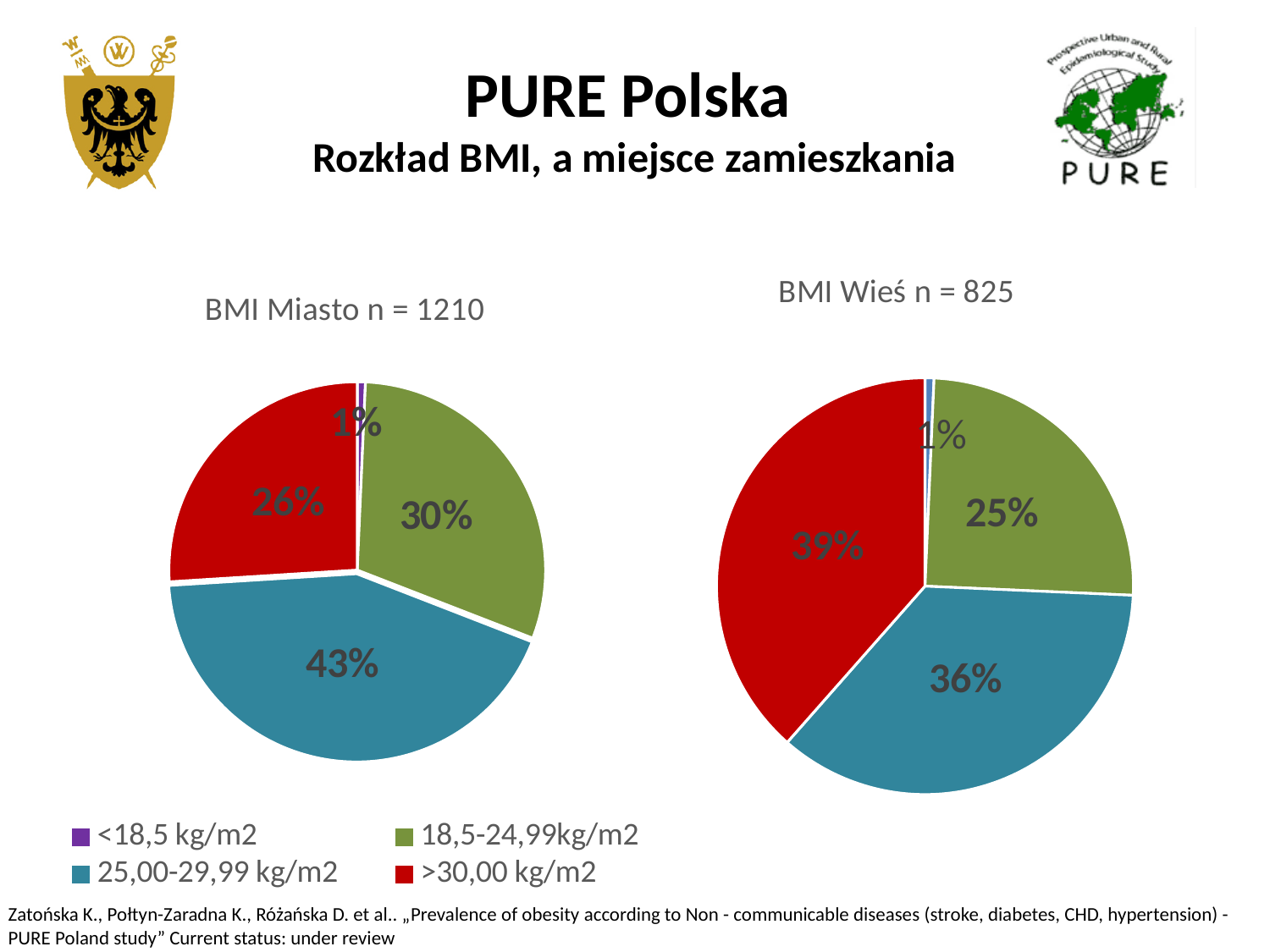
In the BMI Miasto n = 1210 chart, which BMI category has the smallest slice? <18,5 kg/m2 In the BMI Wieś n = 825 chart, what share is the 25,00-29,99 kg/m2 slice? 36% In the BMI Wieś n = 825 chart, which BMI category has the largest slice? >30,00 kg/m2 In the BMI Wieś n = 825 chart, what share is the 18,5-24,99kg/m2 slice? 25% What type of chart is used for BMI Miasto n = 1210? pie chart In the BMI Miasto n = 1210 chart, what share is the >30,00 kg/m2 slice? 26% How many BMI categories does the legend list? 4 What is the difference between the >30,00 kg/m2 share in the BMI Wieś n = 825 chart and the >30,00 kg/m2 share in the BMI Miasto n = 1210 chart? 13% Which is larger: the 25,00-29,99 kg/m2 share in the BMI Miasto n = 1210 chart or in the BMI Wieś n = 825 chart? BMI Miasto n = 1210